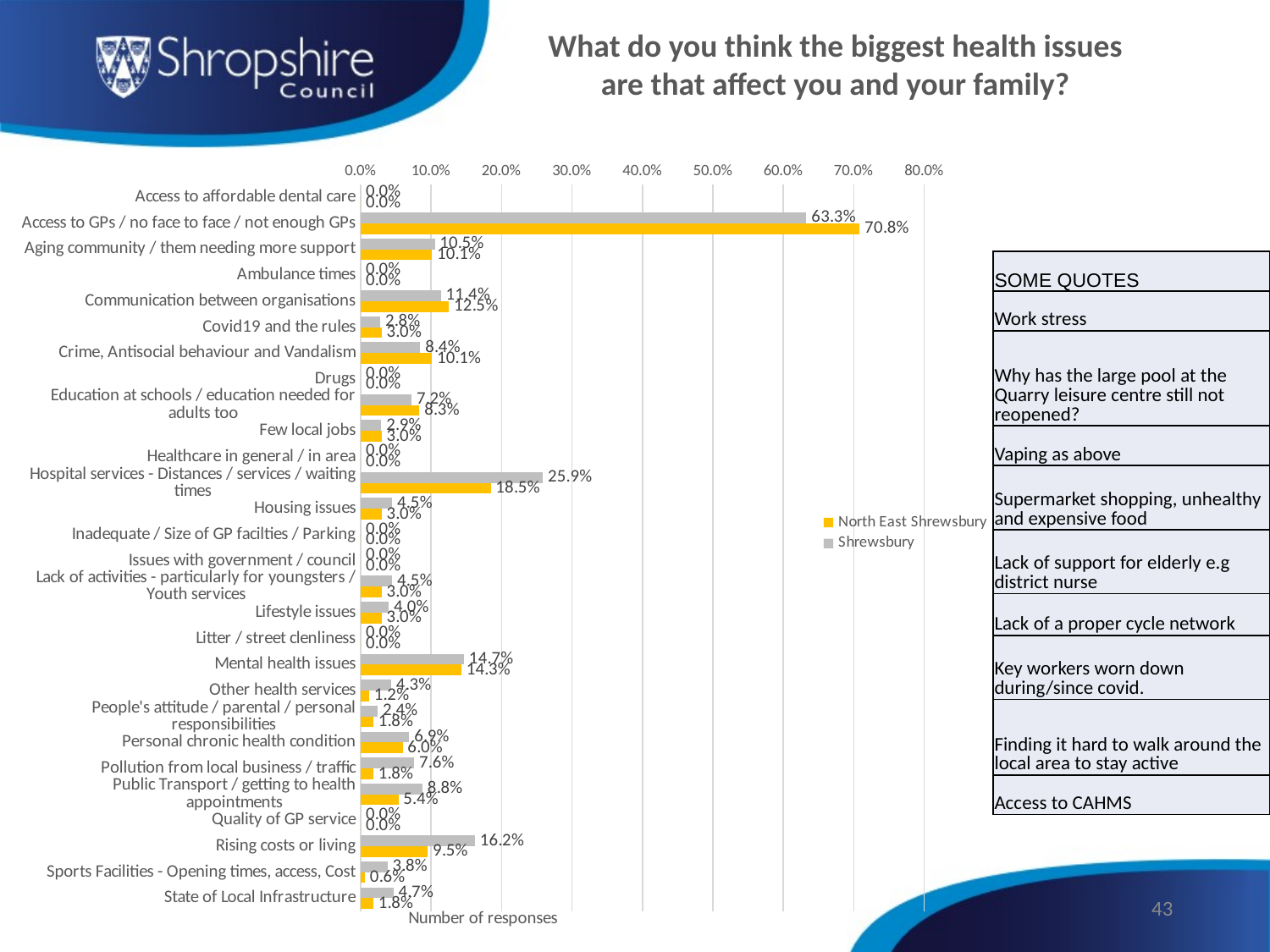
What is the Shrewsbury value for 'Hospital services - Distances / services / waiting times'? 25.9% How many categories are shown on the chart? 28 What percentage of North East Shrewsbury responses cited 'Access to GPs / no face to face / not enough GPs'? 70.8% Which category has the highest value for the North East Shrewsbury series? Access to GPs / no face to face / not enough GPs How many series does the chart legend list? 2 Is the Shrewsbury value for 'Access to GPs / no face to face / not enough GPs' greater or less than 50.0%? greater What is the North East Shrewsbury value for 'Mental health issues'? 14.3% What type of chart is shown on the slide? Bar chart What is the Shrewsbury value for 'Rising costs or living'? 16.2% For 'Pollution from local business / traffic', which series has the larger value, Shrewsbury or North East Shrewsbury? Shrewsbury For 'Hospital services - Distances / services / waiting times', which series has the larger value, Shrewsbury or North East Shrewsbury? Shrewsbury What is the difference between the North East Shrewsbury and Shrewsbury values for 'Access to GPs / no face to face / not enough GPs'? 7.5 percentage points